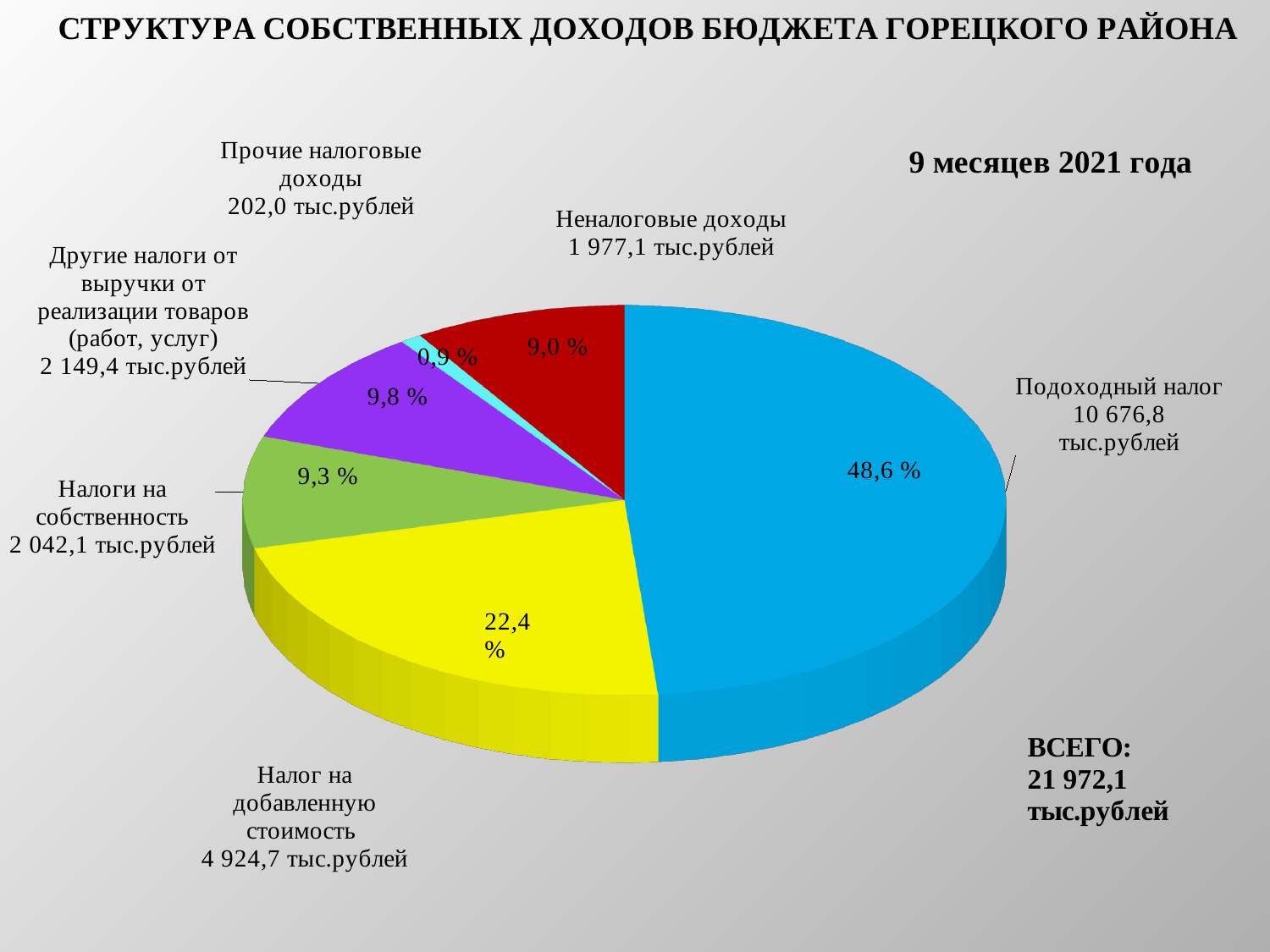
What is the difference between the values for Подоходный налог and Налог на добавленную стоимость? 5 752,1 тыс.рублей Which category has the largest slice of the pie? Подоходный налог How many slices does the pie chart have? 6 Which is larger: Другие налоги от выручки от реализации товаров (работ, услуг) or Налоги на собственность? Другие налоги от выручки от реализации товаров (работ, услуг) What is the value for Неналоговые доходы? 1 977,1 тыс.рублей What period does the chart cover, according to the slide? 9 месяцев 2021 года What share of the pie does Подоходный налог represent? 48,6 % Which category has the smallest slice of the pie? Прочие налоговые доходы What is the value for Подоходный налог? 10 676,8 тыс.рублей What kind of chart is shown on the slide? Pie chart What share of the pie does Налоги на собственность represent? 9,3 % What is the value for Налог на добавленную стоимость? 4 924,7 тыс.рублей